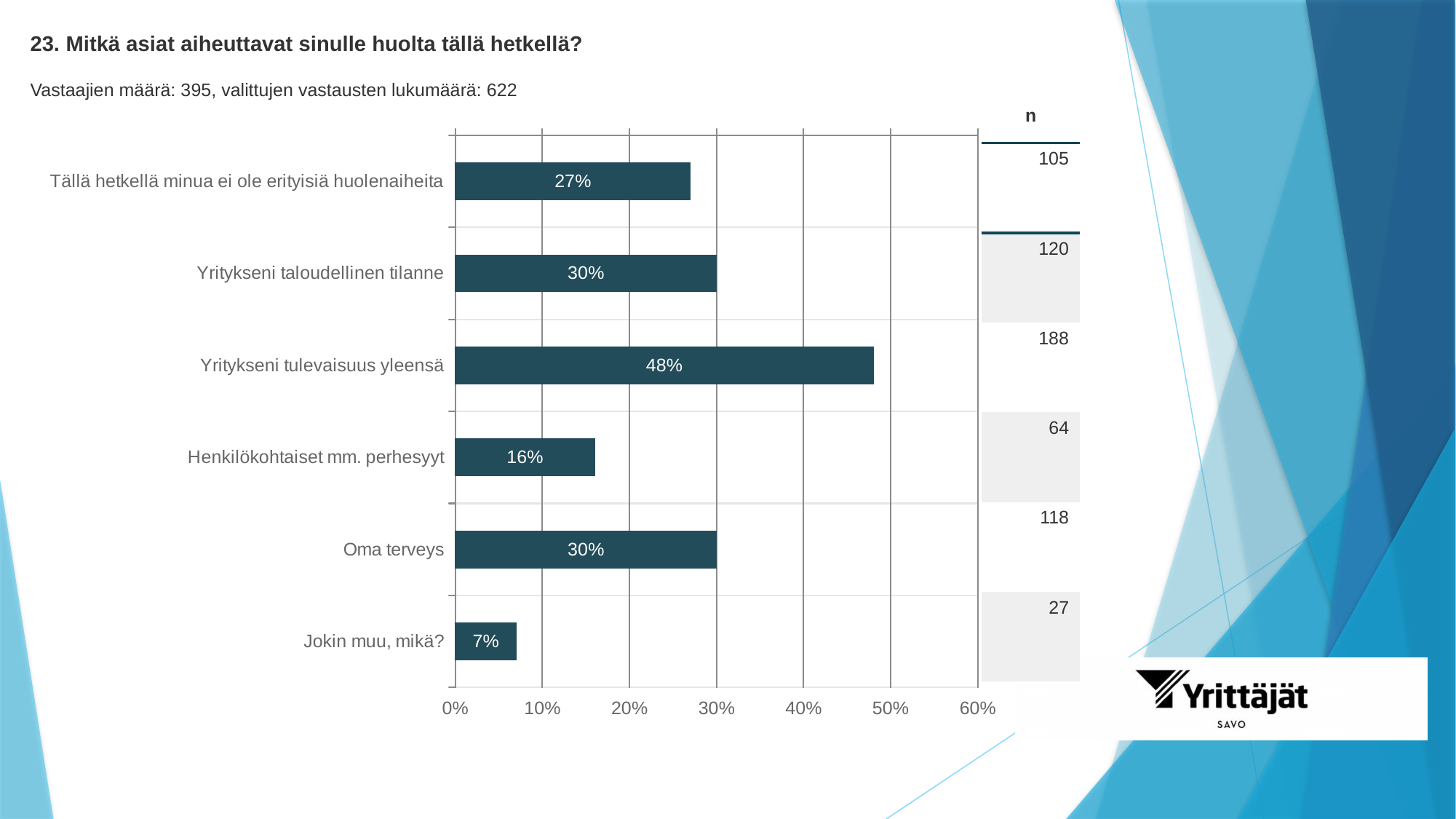
What percentage is shown for "Henkilökohtaiset mm. perhesyyt"? 16% What is the difference in percentage points between "Yritykseni tulevaisuus yleensä" and "Tällä hetkellä minua ei ole erityisiä huolenaiheita"? 21 percentage points What is the maximum value shown on the x axis? 60% How many categories are shown in the chart? 6 Is the value for "Yritykseni tulevaisuus yleensä" greater or less than 40%? greater Which category has the lowest percentage? Jokin muu, mikä? Which has a higher percentage, "Oma terveys" or "Henkilökohtaiset mm. perhesyyt"? Oma terveys Which category has the highest percentage? Yritykseni tulevaisuus yleensä What percentage is shown for "Yritykseni tulevaisuus yleensä"? 48% What kind of chart is shown on the slide? Bar chart What is the n value shown for "Jokin muu, mikä?"? 27 What is the n value shown for "Oma terveys"? 118